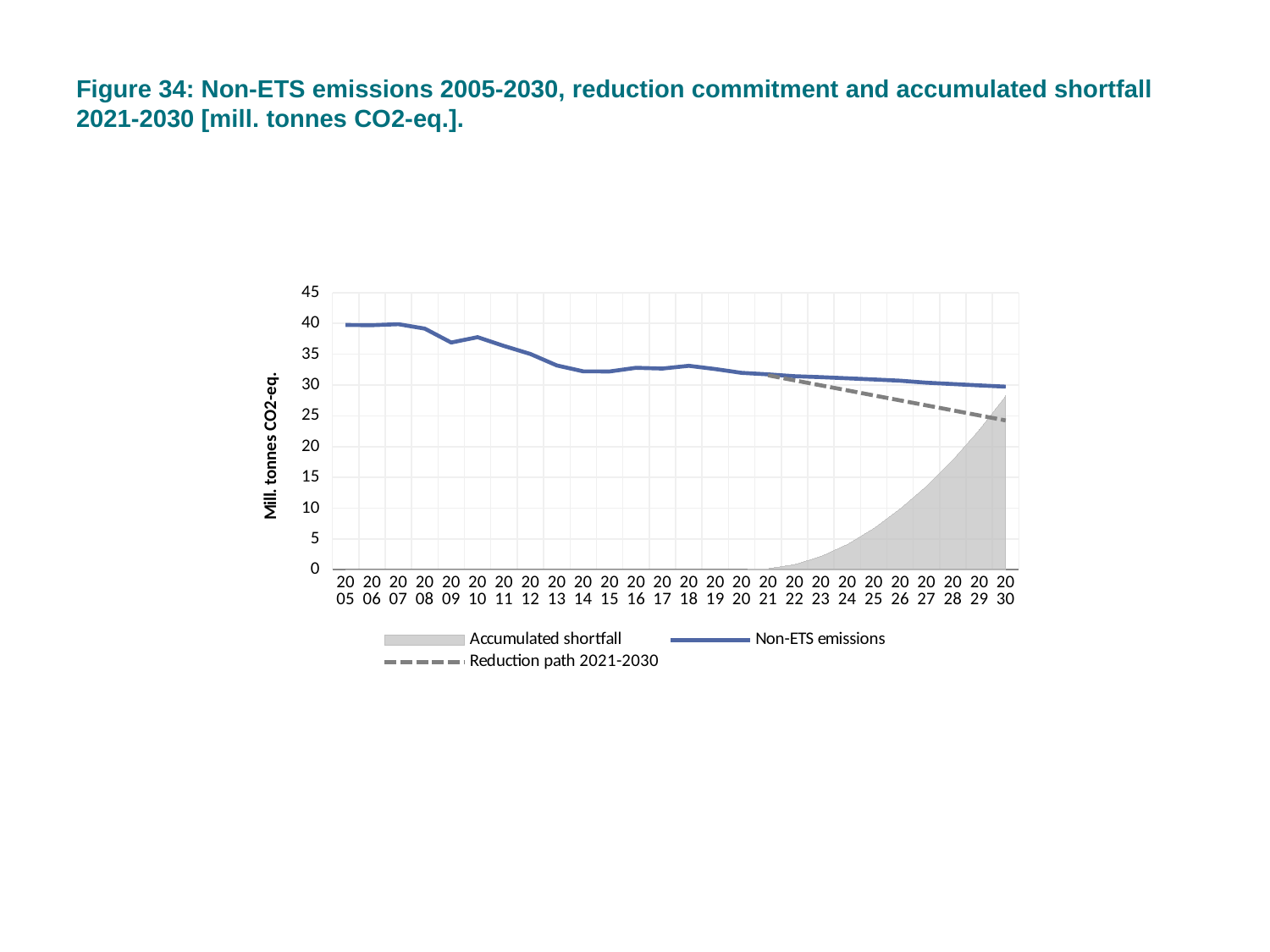
Which is larger in 2030: Non-ETS emissions or the Reduction path 2021-2030? Non-ETS emissions Is the value for Non-ETS emissions in 2030 greater or less than 35? less How many series does the legend list? 3 Is the value for Non-ETS emissions in 2005 greater or less than 35? greater What kind of chart is shown on the slide? combination area and line chart Does the Accumulated shortfall rise or fall from 2021 to 2030? rise Do Non-ETS emissions rise or fall overall from 2005 to 2030? fall Is the value for Accumulated shortfall in 2021 greater or less than 5? less How many years are shown along the x axis? 26 What is the label on the y axis? Mill. tonnes CO2-eq.